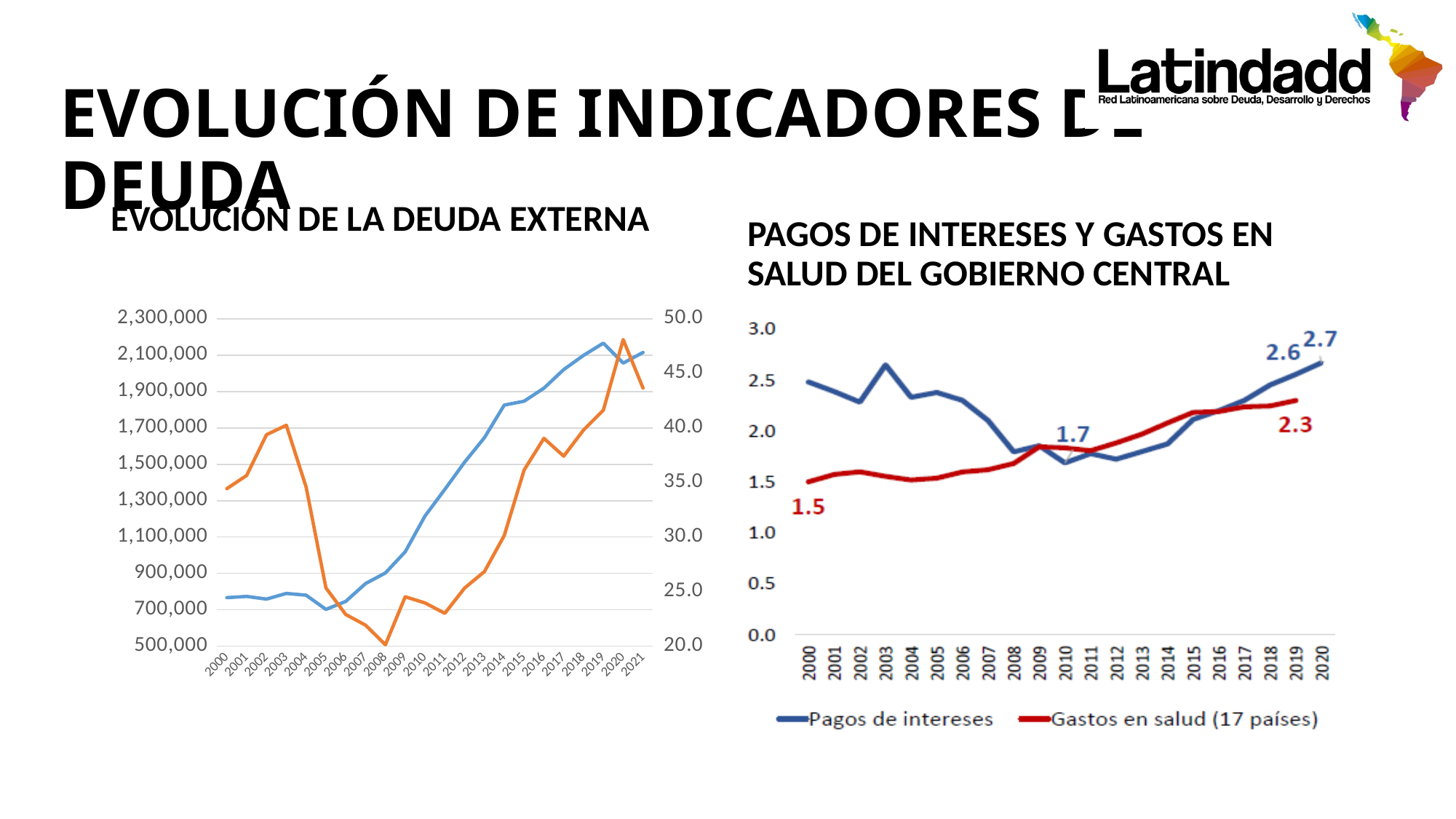
In the chart titled 'PAGOS DE INTERESES Y GASTOS EN SALUD DEL GOBIERNO CENTRAL', what is the difference between Pagos de intereses and Gastos en salud in 2019? 0.3 In the chart titled 'PAGOS DE INTERESES Y GASTOS EN SALUD DEL GOBIERNO CENTRAL', which series has the higher value in 2019, Pagos de intereses or Gastos en salud? Pagos de intereses In the chart titled 'PAGOS DE INTERESES Y GASTOS EN SALUD DEL GOBIERNO CENTRAL', does the Pagos de intereses line rise or fall between 2012 and 2020? Rise In the chart titled 'PAGOS DE INTERESES Y GASTOS EN SALUD DEL GOBIERNO CENTRAL', how many series does the legend list? 2 In the chart titled 'PAGOS DE INTERESES Y GASTOS EN SALUD DEL GOBIERNO CENTRAL', what is the value of Pagos de intereses in 2020? 2.7 In the chart titled 'PAGOS DE INTERESES Y GASTOS EN SALUD DEL GOBIERNO CENTRAL', what kind of chart is shown? Line chart In the chart titled 'PAGOS DE INTERESES Y GASTOS EN SALUD DEL GOBIERNO CENTRAL', how many years are shown on the x axis? 21 In the chart titled 'EVOLUCIÓN DE LA DEUDA EXTERNA', how many years are shown on the x axis? 22 In the chart titled 'PAGOS DE INTERESES Y GASTOS EN SALUD DEL GOBIERNO CENTRAL', is the value of Pagos de intereses in 2003 greater or less than 2.5? greater In the chart titled 'PAGOS DE INTERESES Y GASTOS EN SALUD DEL GOBIERNO CENTRAL', what is the value of Gastos en salud in 2019? 2.3 In the chart titled 'PAGOS DE INTERESES Y GASTOS EN SALUD DEL GOBIERNO CENTRAL', what is the value of Gastos en salud in 2000? 1.5 In the chart titled 'PAGOS DE INTERESES Y GASTOS EN SALUD DEL GOBIERNO CENTRAL', what is the value of Pagos de intereses in 2010? 1.7